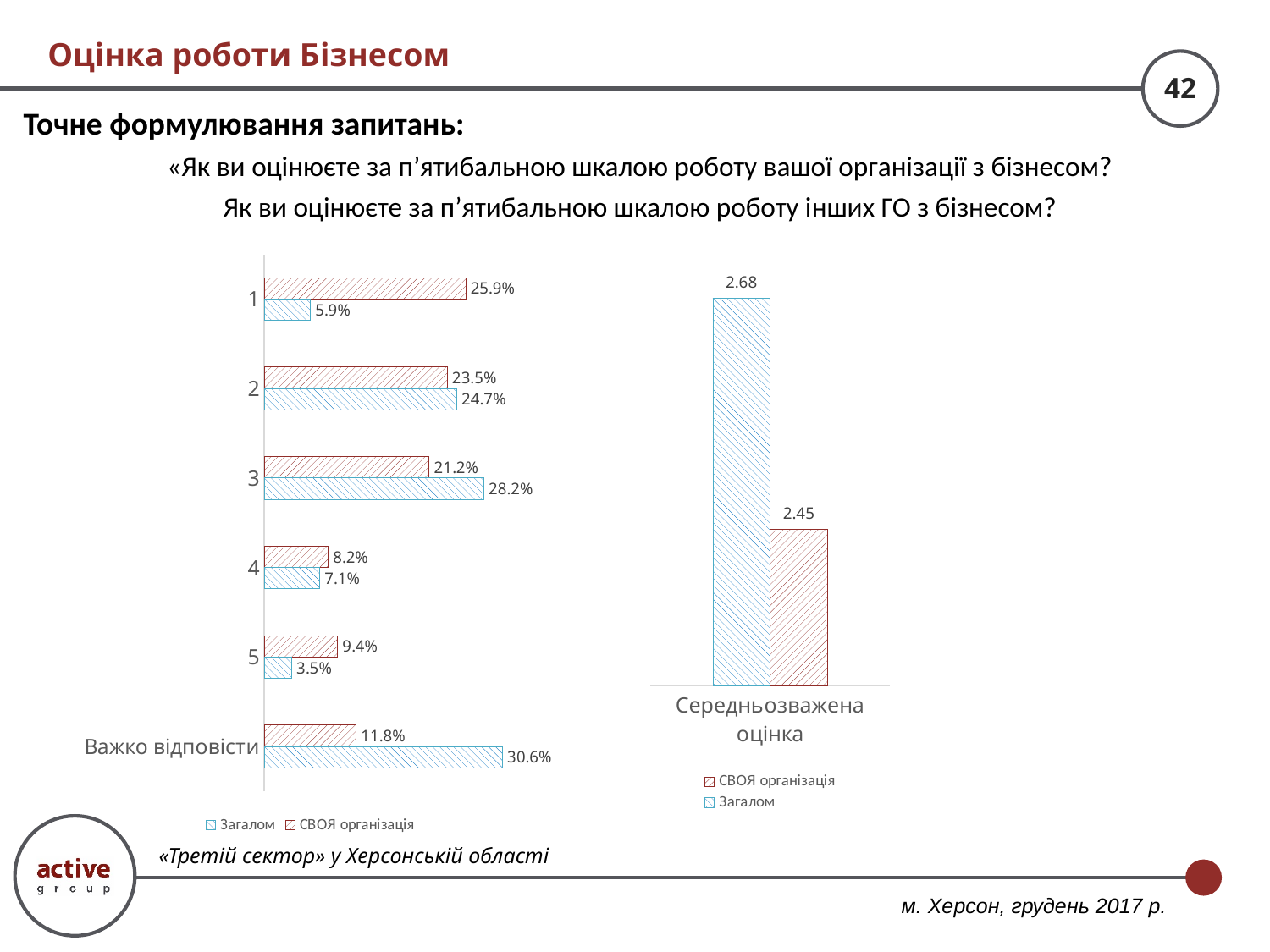
In the left bar chart, which category has the highest value in the Загалом series? Важко відповісти How many categories are shown in the left bar chart? 6 In the left bar chart, which category has the lowest value in the Загалом series? 5 In the left bar chart, what is the value for category 1 in the СВОЯ організація series? 25.9% In the left bar chart, what is the value for Важко відповісти in the Загалом series? 30.6% In the right chart titled Середньозважена оцінка, what is the difference between the Загалом and СВОЯ організація values? 0.23 In the left bar chart, for category 5, which series has the larger value: Загалом or СВОЯ організація? СВОЯ організація How many series does the legend of the left bar chart list? 2 In the left bar chart, what is the difference between the СВОЯ організація and Загалом values for category 1? 20.0% In the left bar chart, which category has the highest value in the СВОЯ організація series? 1 In the right chart titled Середньозважена оцінка, what is the value for Загалом? 2.68 In the left bar chart, what is the value for category 3 in the Загалом series? 28.2%